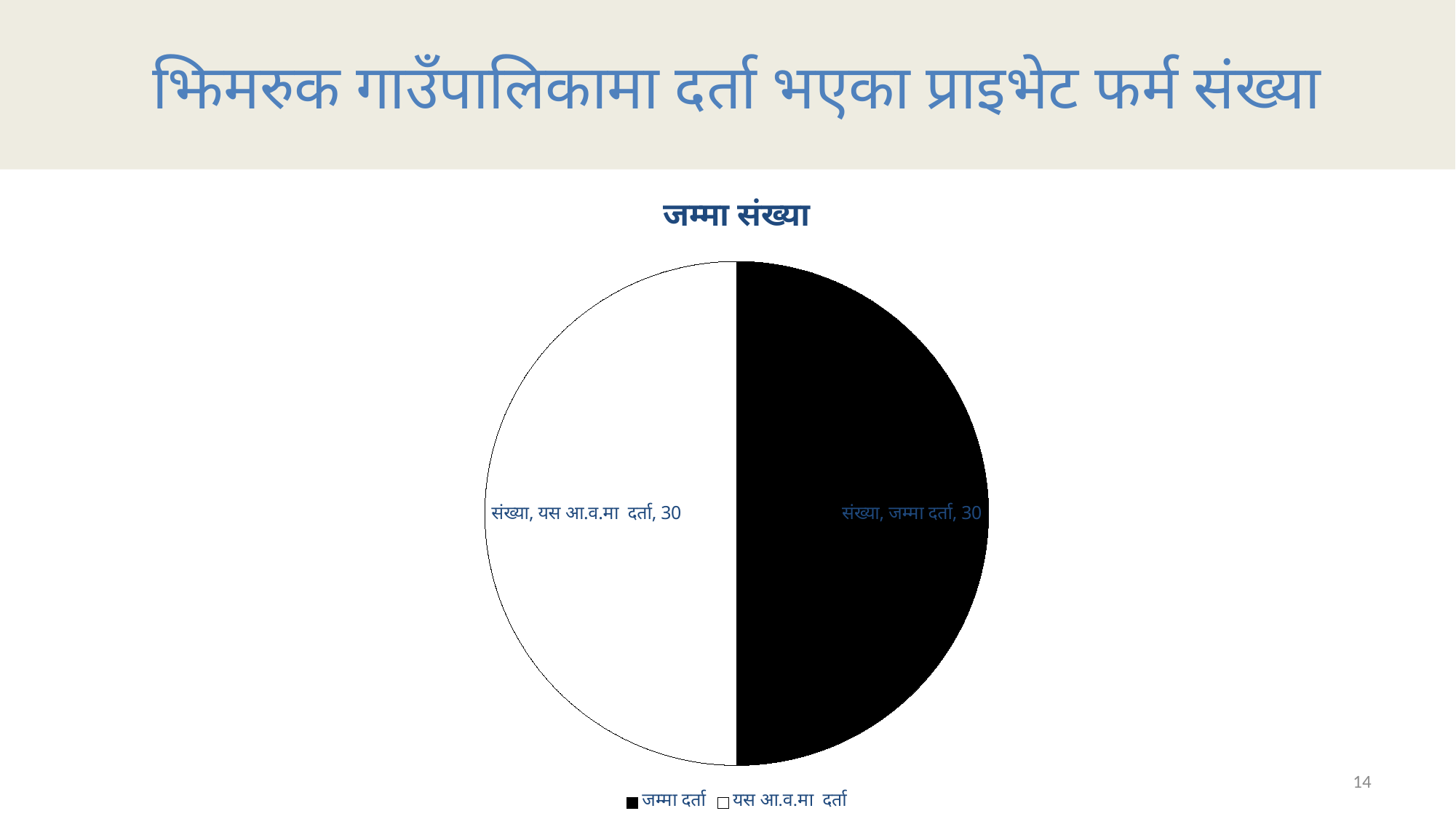
Which colour is used for the जम्मा दर्ता slice? black How many entries does the legend list? 2 What is the difference between the values for जम्मा दर्ता and यस आ.व.मा दर्ता? 0 How many slices does the pie chart have? 2 What is the value for जम्मा दर्ता? 30 What is the title of the chart? जम्मा संख्या What share of the pie does the यस आ.व.मा दर्ता slice represent? 50% What kind of chart is shown on the slide? pie chart What is the total of all slices in the pie chart? 60 What is the value for यस आ.व.मा दर्ता? 30 What share of the pie does the जम्मा दर्ता slice represent? 50%